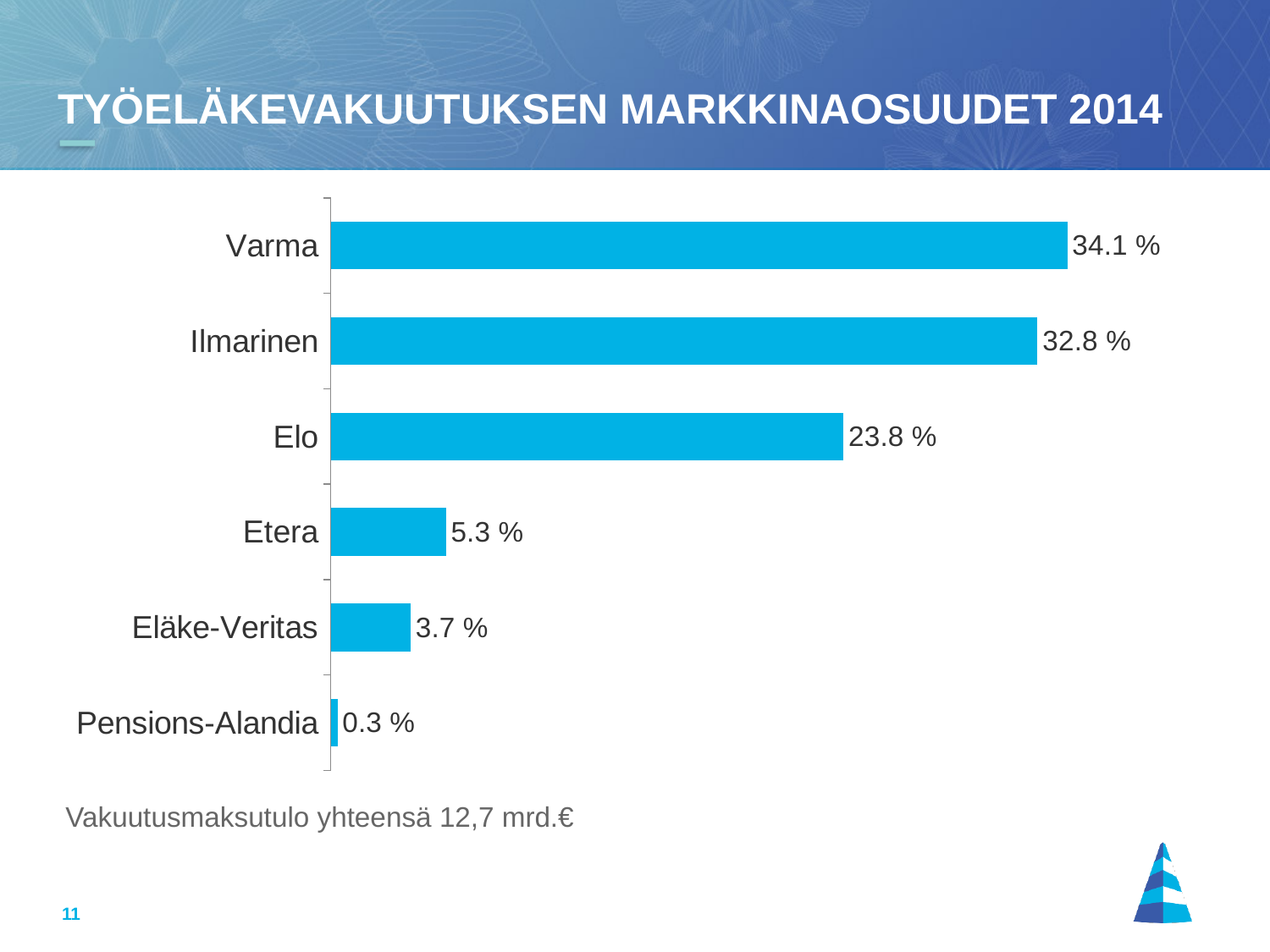
What is the difference in market share between Varma and Ilmarinen? 1.3 % What is the market share shown for Pensions-Alandia? 0.3 % What is the difference in market share between Etera and Eläke-Veritas? 1.6 % Which company has the lowest market share? Pensions-Alandia What kind of chart is shown on the slide? Bar chart What is the market share shown for Varma? 34.1 % Which has a larger market share, Elo or Etera? Elo What is the market share shown for Eläke-Veritas? 3.7 % Which company has the highest market share? Varma How many companies are shown in the chart? 6 What is the title of the slide? TYÖELÄKEVAKUUTUKSEN MARKKINAOSUUDET 2014 What is the market share shown for Elo? 23.8 %